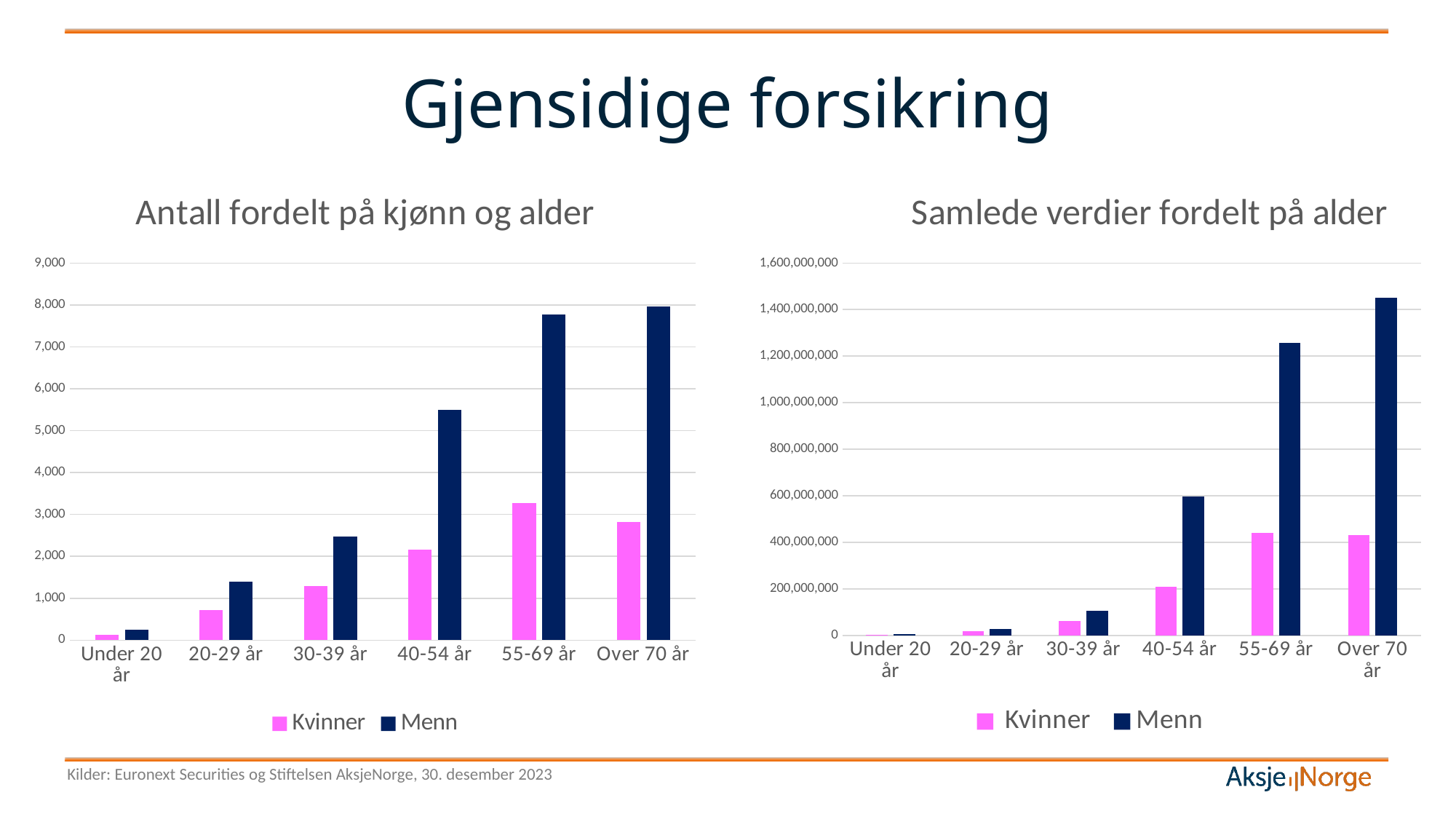
In the left chart 'Antall fordelt på kjønn og alder', how many series does the legend list? 2 In the left chart 'Antall fordelt på kjønn og alder', is the value for Menn in the 40-54 år group greater or less than 5,000? greater In the left chart 'Antall fordelt på kjønn og alder', what colour represents the Kvinner series? Pink In the right chart 'Samlede verdier fordelt på alder', is the value for Menn in the 55-69 år group greater or less than 1,000,000,000? greater What kind of chart is the left chart, 'Antall fordelt på kjønn og alder'? Bar chart In the right chart 'Samlede verdier fordelt på alder', do the values for Menn rise or fall as the age groups move from Under 20 år to Over 70 år? rise In the left chart 'Antall fordelt på kjønn og alder', is the value for Kvinner in the Over 70 år group greater or less than 3,000? less In the left chart 'Antall fordelt på kjønn og alder', which age group has the highest value for Kvinner? 55-69 år In the right chart 'Samlede verdier fordelt på alder', which age group has the highest value for Menn? Over 70 år In the right chart 'Samlede verdier fordelt på alder', how many age categories are shown on the x axis? 6 In the left chart 'Antall fordelt på kjønn og alder', which is larger for the 40-54 år group, Kvinner or Menn? Menn